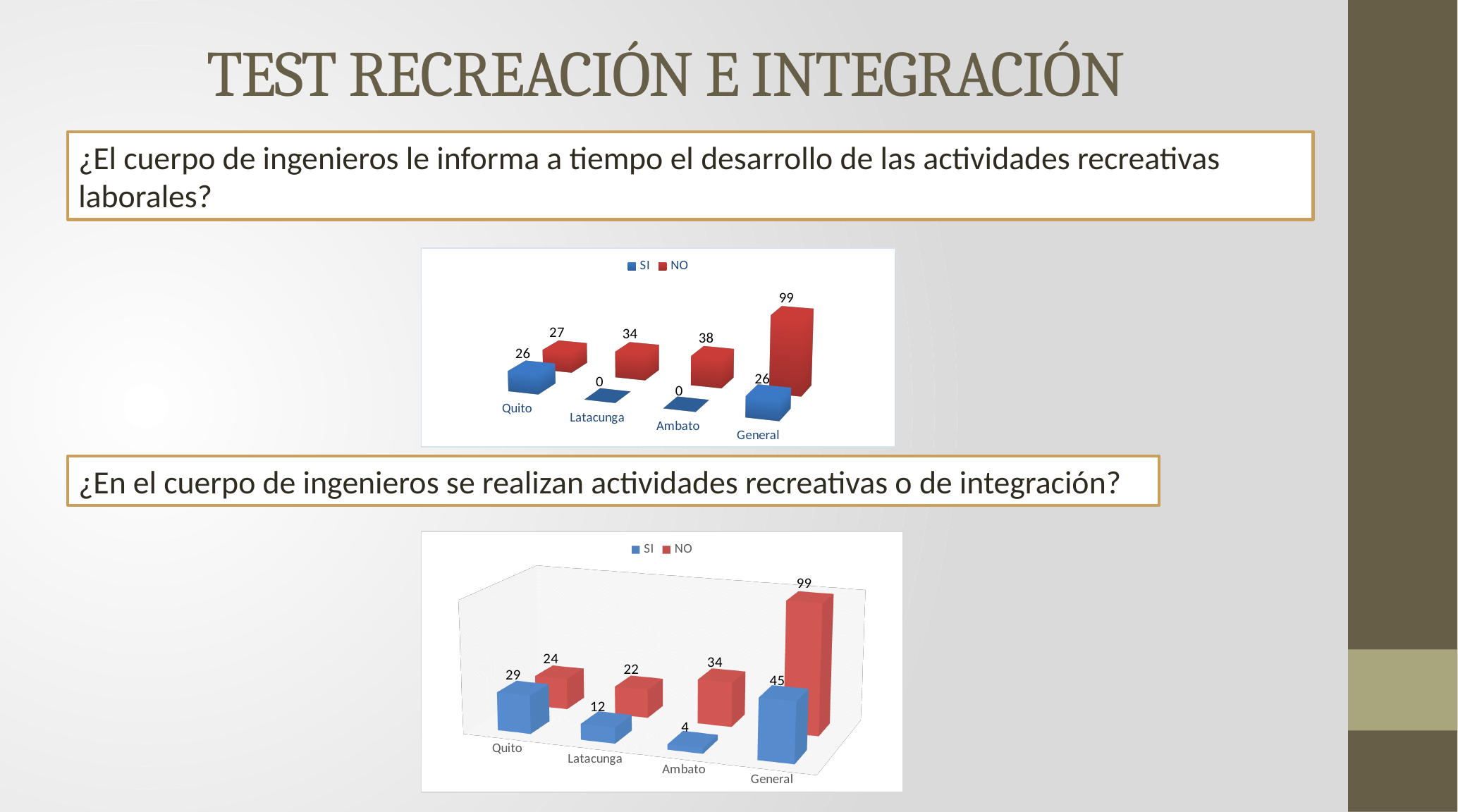
In the bottom chart, which category has the lowest SI value? Ambato In the bottom chart, which is larger for Quito, the SI value or the NO value? SI In the bottom chart, what is the SI value for Latacunga? 12 How many categories are shown on the x axis of the bottom chart? 4 In the top chart, what is the NO value for Ambato? 38 In the bottom chart, what is the difference between the NO values for Ambato and Latacunga? 12 In the top chart, how many series does the legend list? 2 In the top chart, what is the difference between the NO and SI values for General? 73 What kind of chart is the bottom chart? Bar chart In the top chart, what is the SI value for Latacunga? 0 In the top chart, which category has the highest NO value? General In the bottom chart, what is the NO value for Quito? 24